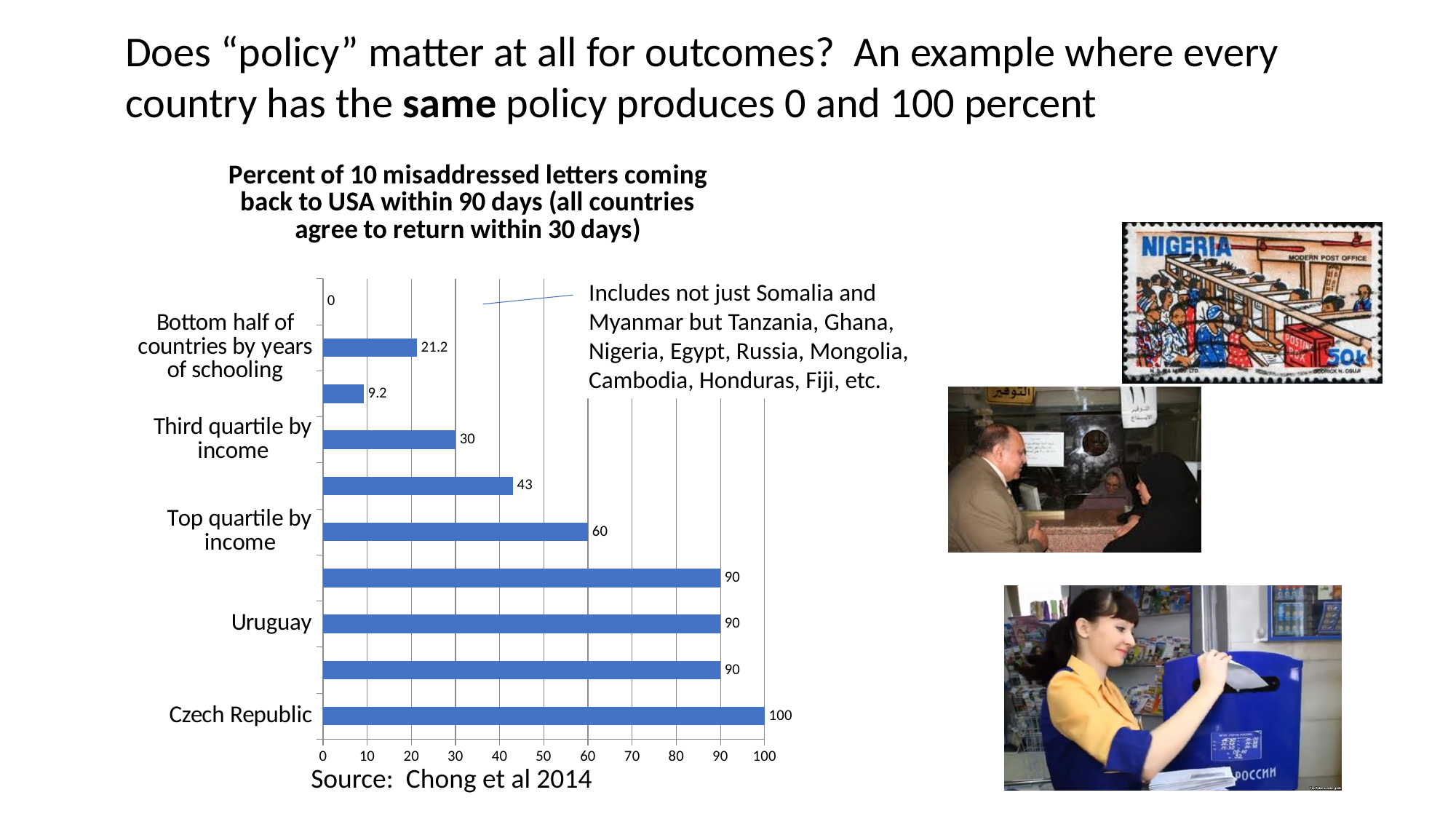
Which is larger, the value for Top quartile by income or Third quartile by income? Top quartile by income What is the difference between the values for Czech Republic and Uruguay? 10 What is the value for Top quartile by income? 60 What is the value for Czech Republic? 100 What is the value for Third quartile by income? 30 What type of chart is shown on the slide? bar chart What source is cited below the chart? Chong et al 2014 What is the value of the shortest bar on the chart? 0 How many bars are plotted on the chart? 10 Which category has the highest value? Czech Republic What is the value for Uruguay? 90 What is the value for Bottom half of countries by years of schooling? 21.2